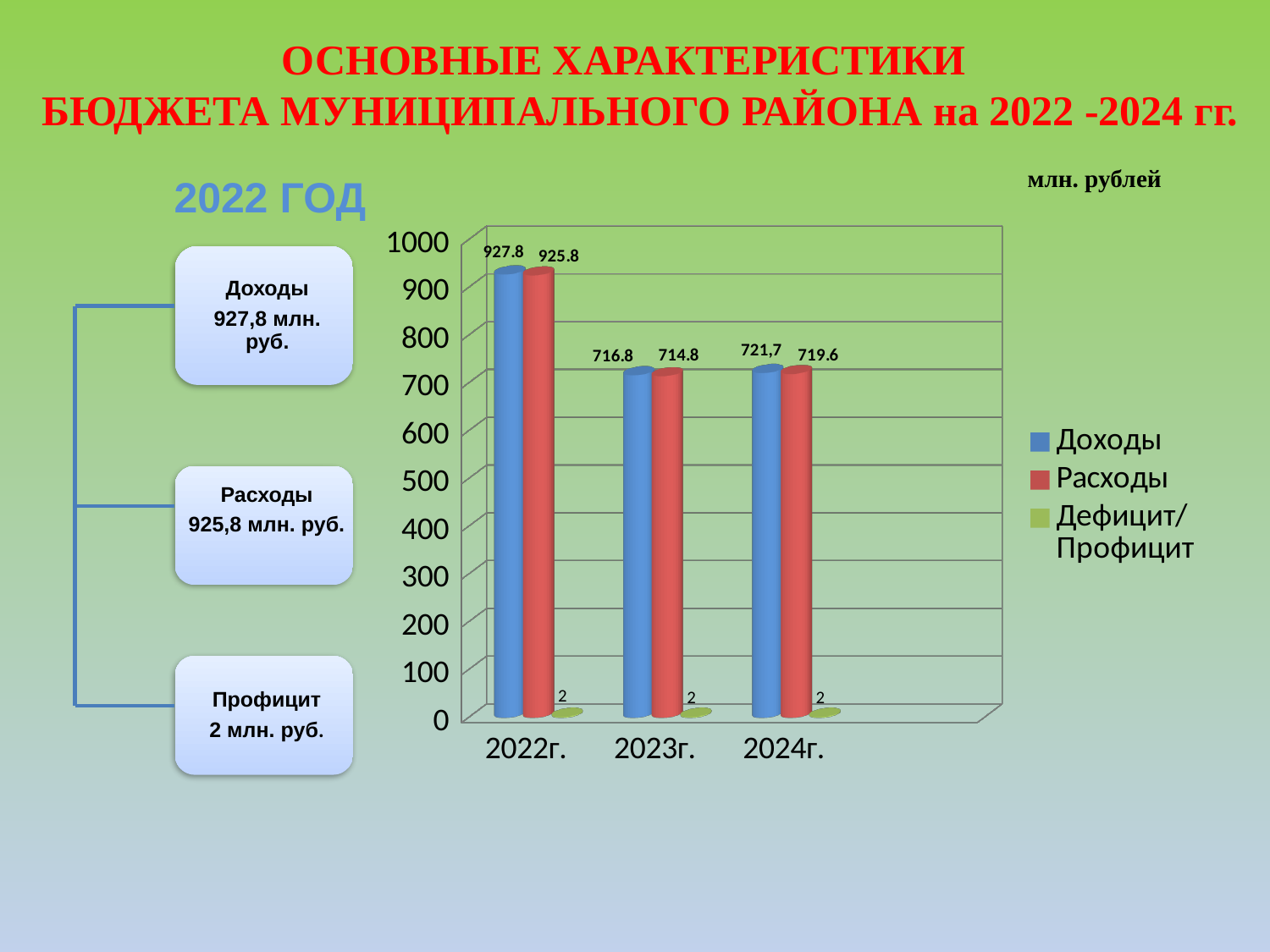
Do the Доходы values rise or fall from 2022г. to 2023г.? fall What kind of chart is shown on the slide? bar chart How many series does the chart legend list? 3 Which is larger, Доходы in 2023г. or Доходы in 2024г.? Доходы in 2024г. What is the value of Доходы for 2024г.? 721,7 What is the value of Дефицит/Профицит for 2023г.? 2 In which year is Расходы the lowest? 2023г. What is the difference between Доходы and Расходы in 2022г.? 2 How many years are shown on the x axis of the chart? 3 In which year is Доходы the highest? 2022г. What is the value of Доходы for 2022г.? 927.8 What is the value of Расходы for 2023г.? 714.8